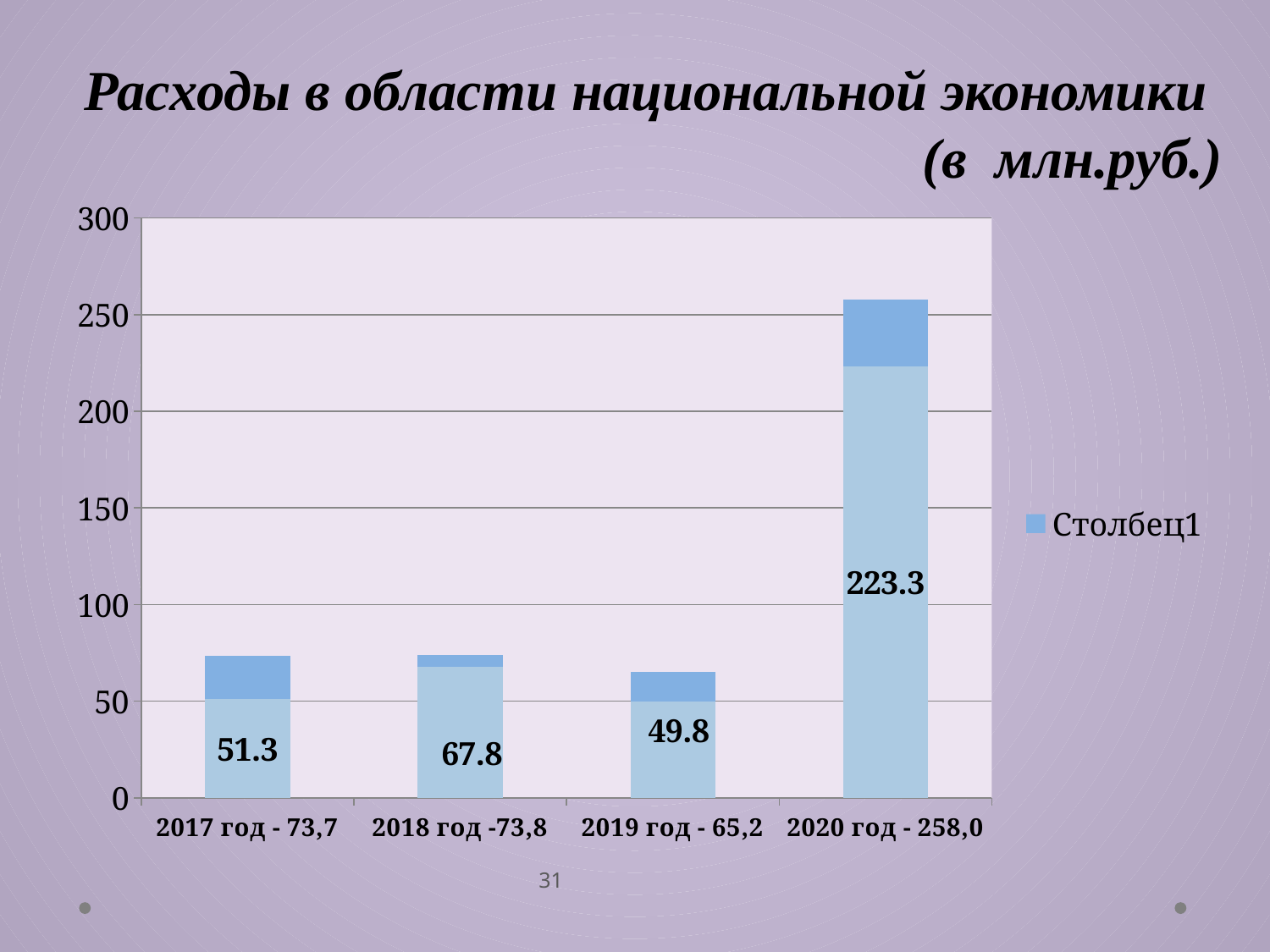
Which category has the lowest labelled value? 2019 год - 65,2 Is the total height of the bar for "2020 год - 258,0" greater or less than 250? greater What is the labelled value of the lower segment for the category "2017 год - 73,7"? 51.3 Which labelled value is larger: 2018 (67.8) or 2019 (49.8)? 2018 (67.8) What is the only entry listed in the legend? Столбец1 Which category has the highest labelled value? 2020 год - 258,0 What is the labelled value of the lower segment for the category "2018 год -73,8"? 67.8 What type of chart is shown on the slide? bar chart How many categories are shown on the x axis? 4 What is the labelled value of the lower segment for the category "2019 год - 65,2"? 49.8 What is the labelled value of the lower segment for the category "2020 год - 258,0"? 223.3 What is the difference between the labelled values for 2020 (223.3) and 2017 (51.3)? 172.0